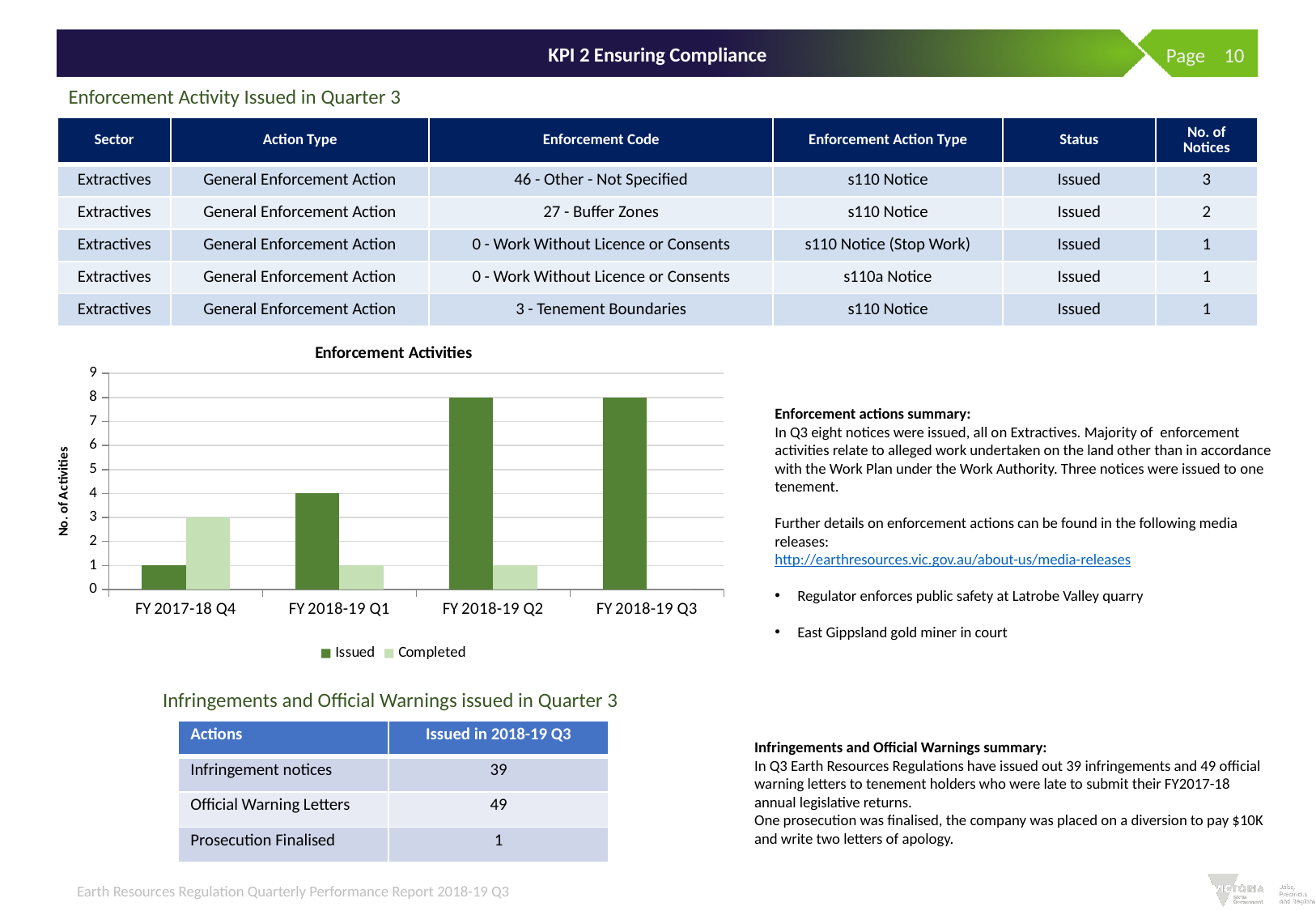
In the Enforcement Activities chart, what is the Completed value for FY 2017-18 Q4? 3 In the Enforcement Activities chart, what is the Issued value for FY 2018-19 Q3? 8 In the Enforcement Activities chart, which quarter has the highest Completed value? FY 2017-18 Q4 How many quarters are shown on the x axis of the Enforcement Activities chart? 4 In the Enforcement Activities chart, what is the difference between the Issued values for FY 2018-19 Q2 and FY 2018-19 Q1? 4 In the Enforcement Activities chart, what is the Issued value for FY 2018-19 Q1? 4 What type of chart is the Enforcement Activities chart? bar chart How many series does the legend of the Enforcement Activities chart list? 2 In the Enforcement Activities chart, which quarter has the lowest Issued value? FY 2017-18 Q4 In the Enforcement Activities chart, which is larger for FY 2017-18 Q4: Issued or Completed? Completed What is the y-axis label of the Enforcement Activities chart? No. of Activities In the Enforcement Activities chart, is the Issued value for FY 2018-19 Q2 greater or less than 5? greater